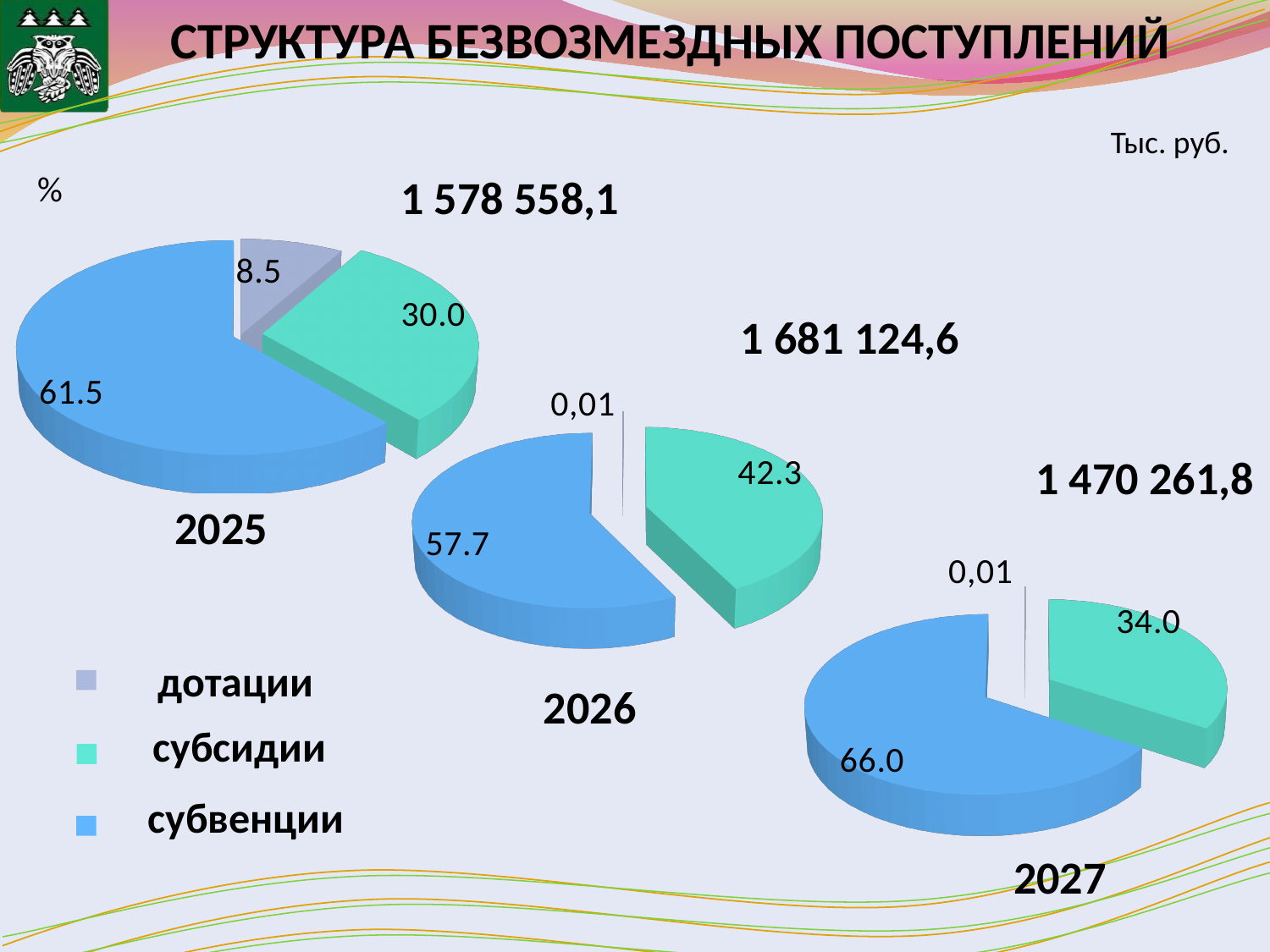
In the 2025 pie chart, which category has the largest share? субвенции In the 2025 pie chart, what is the difference between the shares for субвенции and субсидии? 31.5 In the 2026 pie chart, which category has the smallest share? дотации In the 2025 pie chart, what is the share for субвенции? 61.5 In the 2027 pie chart, what is the share for дотации? 0,01 In the 2025 pie chart, what is the share for дотации? 8.5 In the 2027 pie chart, what is the share for субвенции? 66.0 In the 2026 pie chart, what is the share for субсидии? 42.3 What kind of chart is used to show the structure for each year on this slide? pie chart How many categories does the legend list? 3 What total amount (тыс. руб.) is shown above the 2026 pie chart? 1 681 124,6 In the 2027 pie chart, which is larger: the share for субсидии or the share for субвенции? субвенции